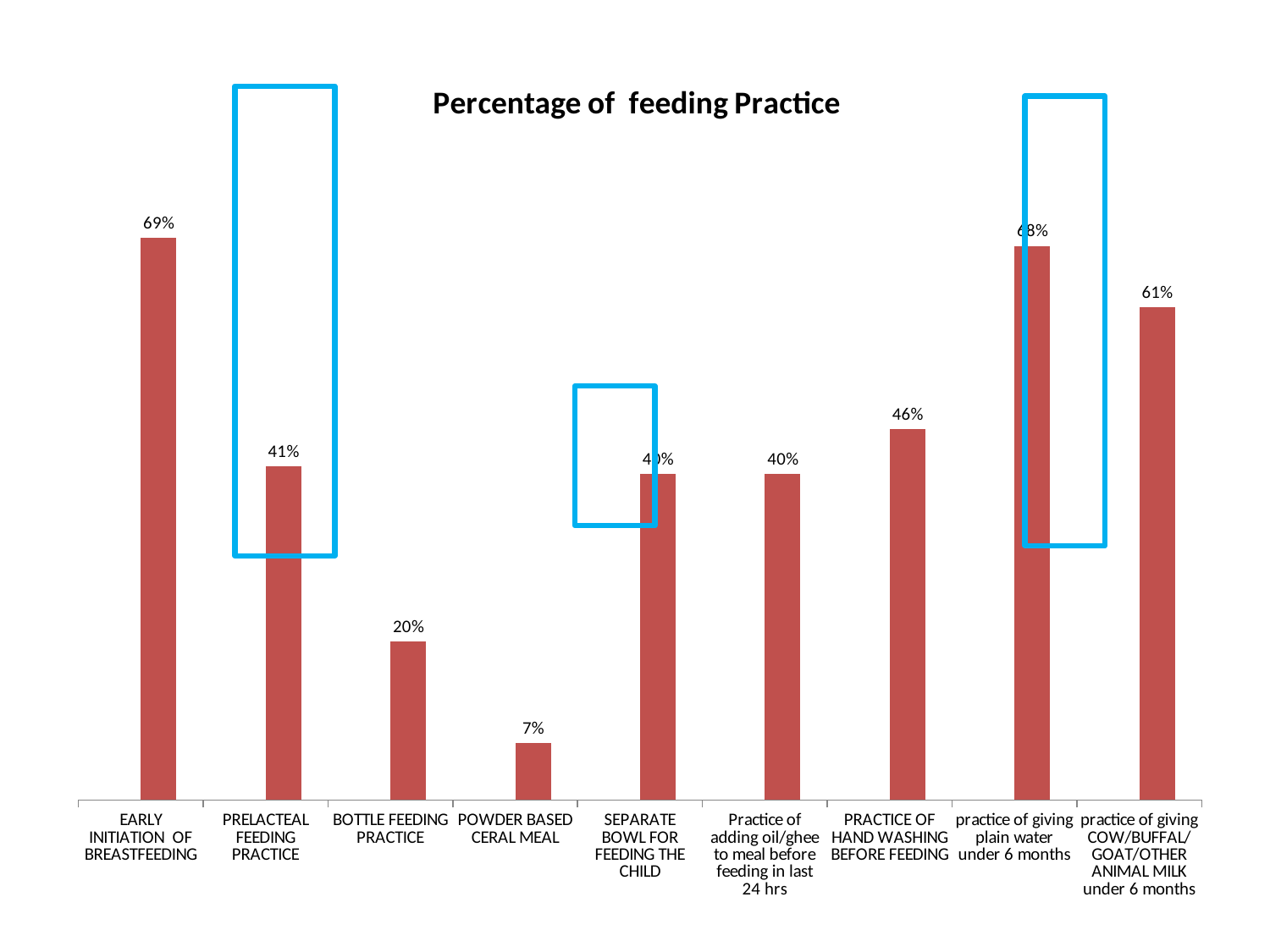
Which feeding practice has the lowest percentage? POWDER BASED CERAL MEAL What is the value for POWDER BASED CERAL MEAL? 7% What is the value for PRACTICE OF HAND WASHING BEFORE FEEDING? 46% What type of chart is shown on the slide? Bar chart Which is larger: PRACTICE OF HAND WASHING BEFORE FEEDING or BOTTLE FEEDING PRACTICE? PRACTICE OF HAND WASHING BEFORE FEEDING What is the value for practice of giving COW/BUFFAL/GOAT/OTHER ANIMAL MILK under 6 months? 61% Which feeding practice has the highest percentage? EARLY INITIATION OF BREASTFEEDING What is the value for BOTTLE FEEDING PRACTICE? 20% What is the difference between the values for EARLY INITIATION OF BREASTFEEDING and PRELACTEAL FEEDING PRACTICE? 28 percentage points What is the value for EARLY INITIATION OF BREASTFEEDING? 69% How many feeding practice categories are shown on the chart? 9 What is the value for PRELACTEAL FEEDING PRACTICE? 41%